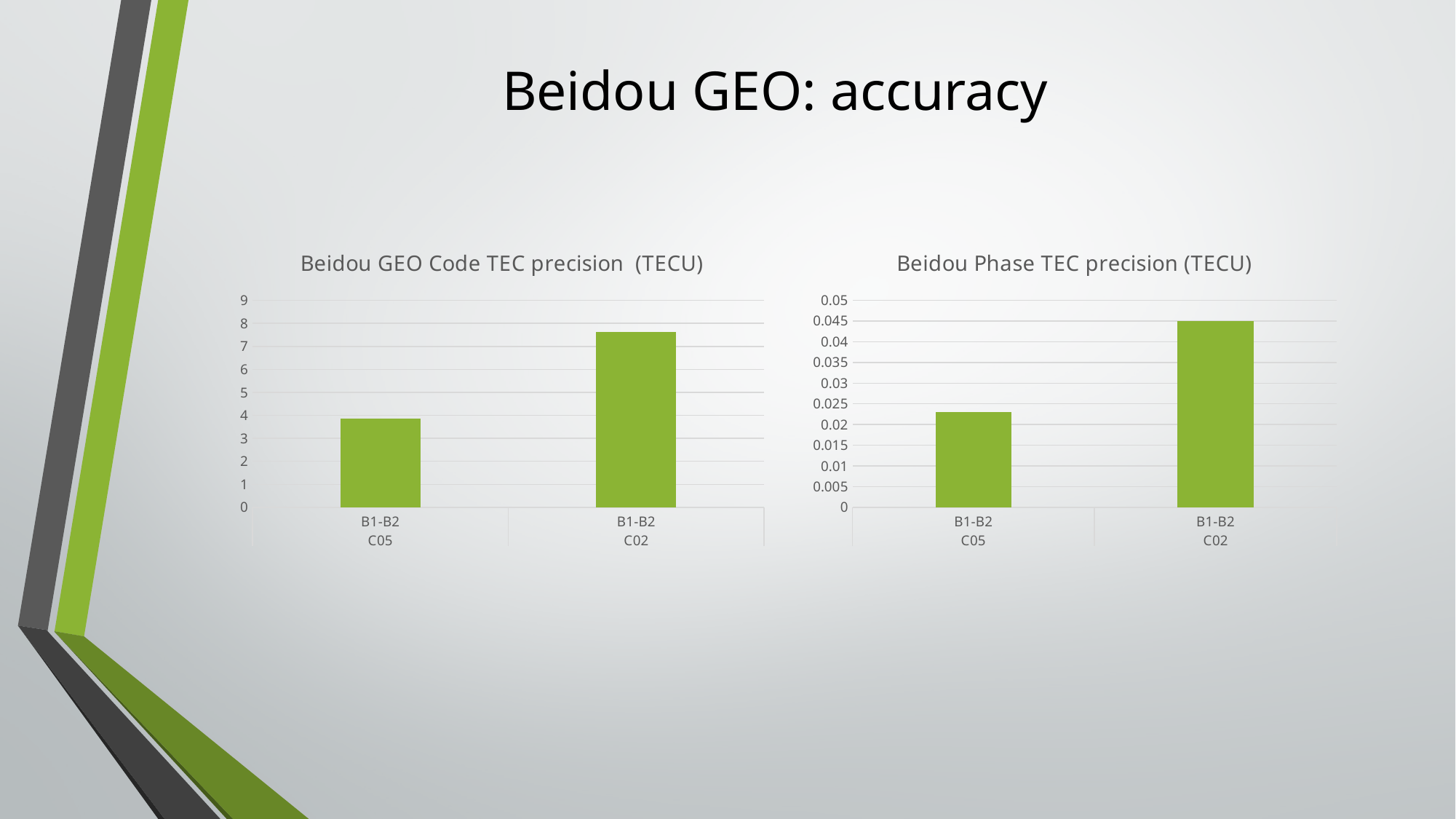
In the 'Beidou GEO Code TEC precision (TECU)' chart, which category has the highest value? B1-B2 C02 In the 'Beidou GEO Code TEC precision (TECU)' chart, is the value for B1-B2 C05 greater or less than 4? less In the 'Beidou GEO Code TEC precision (TECU)' chart, is the value for B1-B2 C02 greater or less than 7? greater In the 'Beidou GEO Code TEC precision (TECU)' chart, which is larger: the value for B1-B2 C05 or B1-B2 C02? B1-B2 C02 What kind of chart is the 'Beidou GEO Code TEC precision (TECU)' chart? bar chart In the 'Beidou Phase TEC precision (TECU)' chart, is the value for B1-B2 C02 greater or less than 0.04? greater What is the title of the chart on the right side of the slide? Beidou Phase TEC precision (TECU) In the 'Beidou Phase TEC precision (TECU)' chart, do the values rise or fall from B1-B2 C05 to B1-B2 C02? rise In the 'Beidou Phase TEC precision (TECU)' chart, which category has the lowest value? B1-B2 C05 What is the highest value shown on the vertical axis of the 'Beidou GEO Code TEC precision (TECU)' chart? 9 How many bars are shown in the 'Beidou Phase TEC precision (TECU)' chart? 2